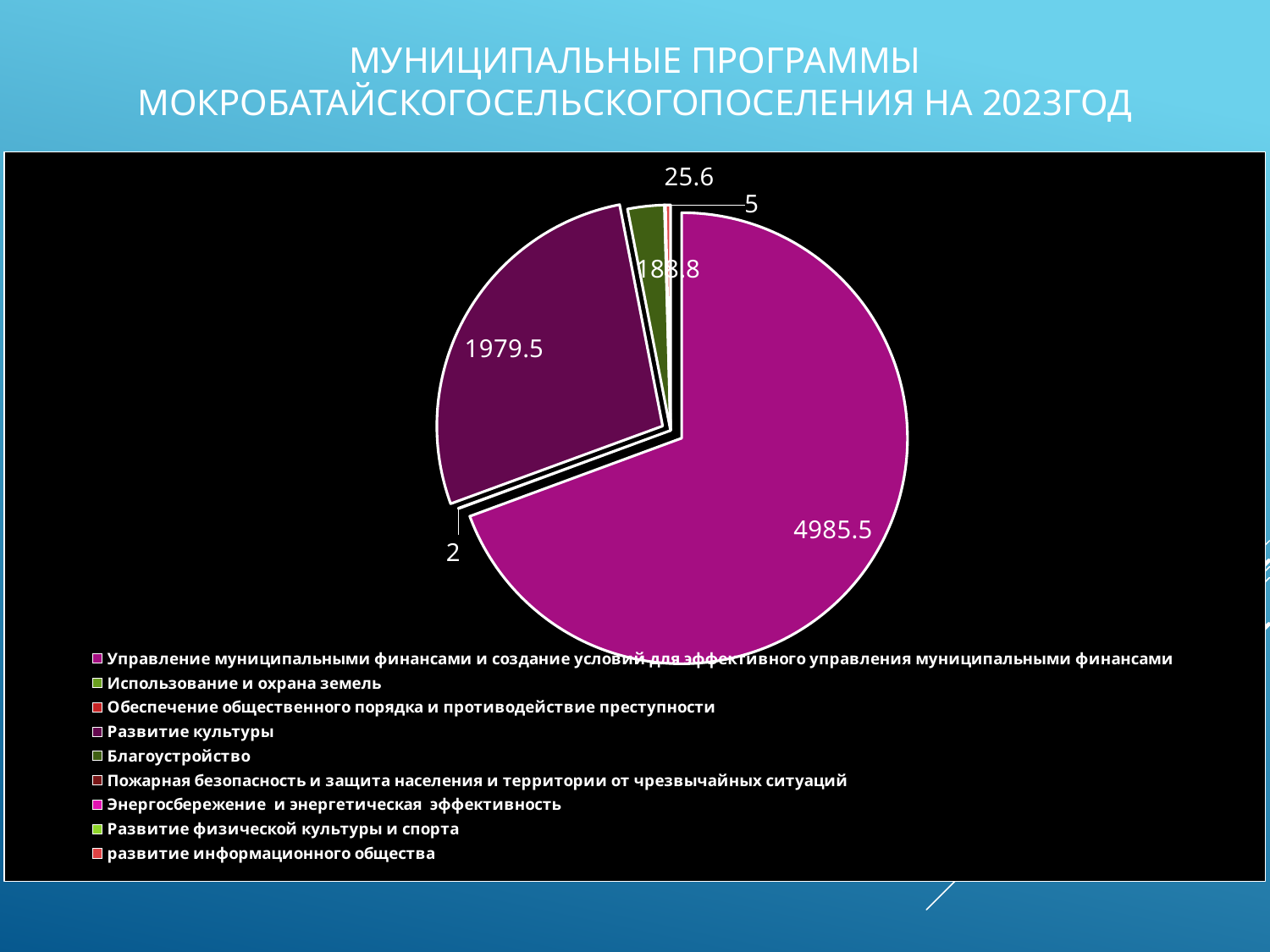
What is the difference between the labelled values 1979.5 and 188.8 on the pie chart? 1790.7 How many entries does the legend of the pie chart list? 9 What kind of chart is shown on the slide? pie chart What year is named in the slide title above the pie chart? 2023 What is the difference between the two largest labelled values on the pie chart, 4985.5 and 1979.5? 3006 How many data labels are shown on the pie chart? 6 What value is labelled on the dark purple slice of the pie chart? 1979.5 What is the smallest value labelled on the pie chart? 2 Which is larger on the pie chart: the slice labelled 1979.5 or the slice labelled 188.8? 1979.5 What is the first entry listed in the legend of the pie chart? Управление муниципальными финансами и создание условий для эффективного управления муниципальными финансами What value is labelled on the largest slice of the pie chart? 4985.5 What value is labelled on the green slice of the pie chart? 188.8